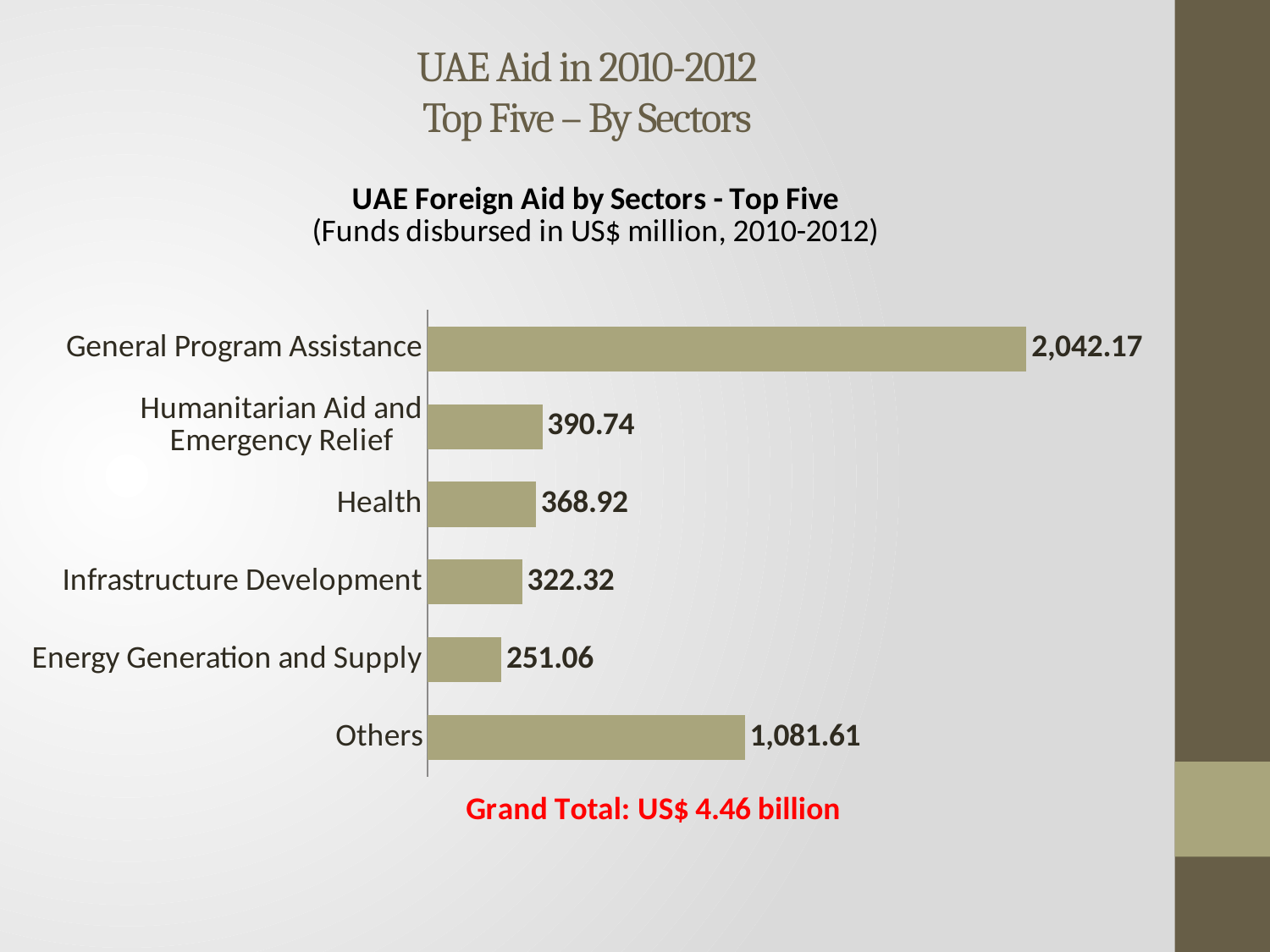
What is the value for Infrastructure Development? 322.32 What is the value for General Program Assistance? 2,042.17 What is the value for Health? 368.92 What is the value for Humanitarian Aid and Emergency Relief? 390.74 Which category has the highest value? General Program Assistance How many categories are shown in the chart? 6 Which is larger, the value for Health or the value for Infrastructure Development? Health What is the value for Others? 1,081.61 What kind of chart is shown on the slide? Bar chart Which category has the lowest value? Energy Generation and Supply What is the value for Energy Generation and Supply? 251.06 What is the difference between the values for General Program Assistance and Others? 960.56